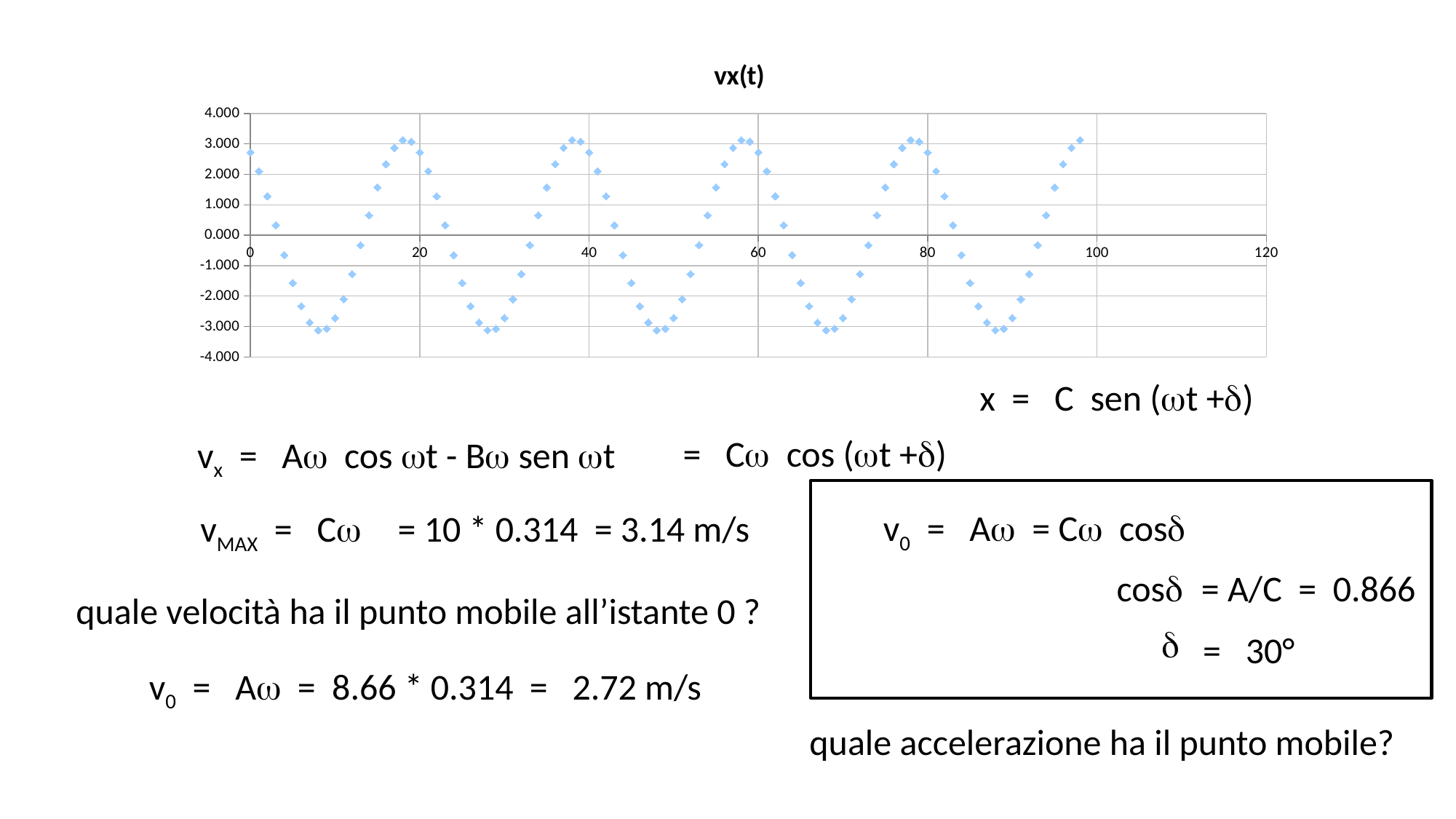
Are the highest points of the curve greater or less than 3.000? greater Do the plotted values rise steadily, fall steadily, or oscillate along the x axis? oscillate Is the value plotted near t = 20 greater or less than 2.000? greater What kind of chart is shown on the slide? scatter chart Are the lowest points of the curve greater or less than -3.000? less What is the highest value shown on the vertical axis? 4.000 What is the title of the chart? vx(t)